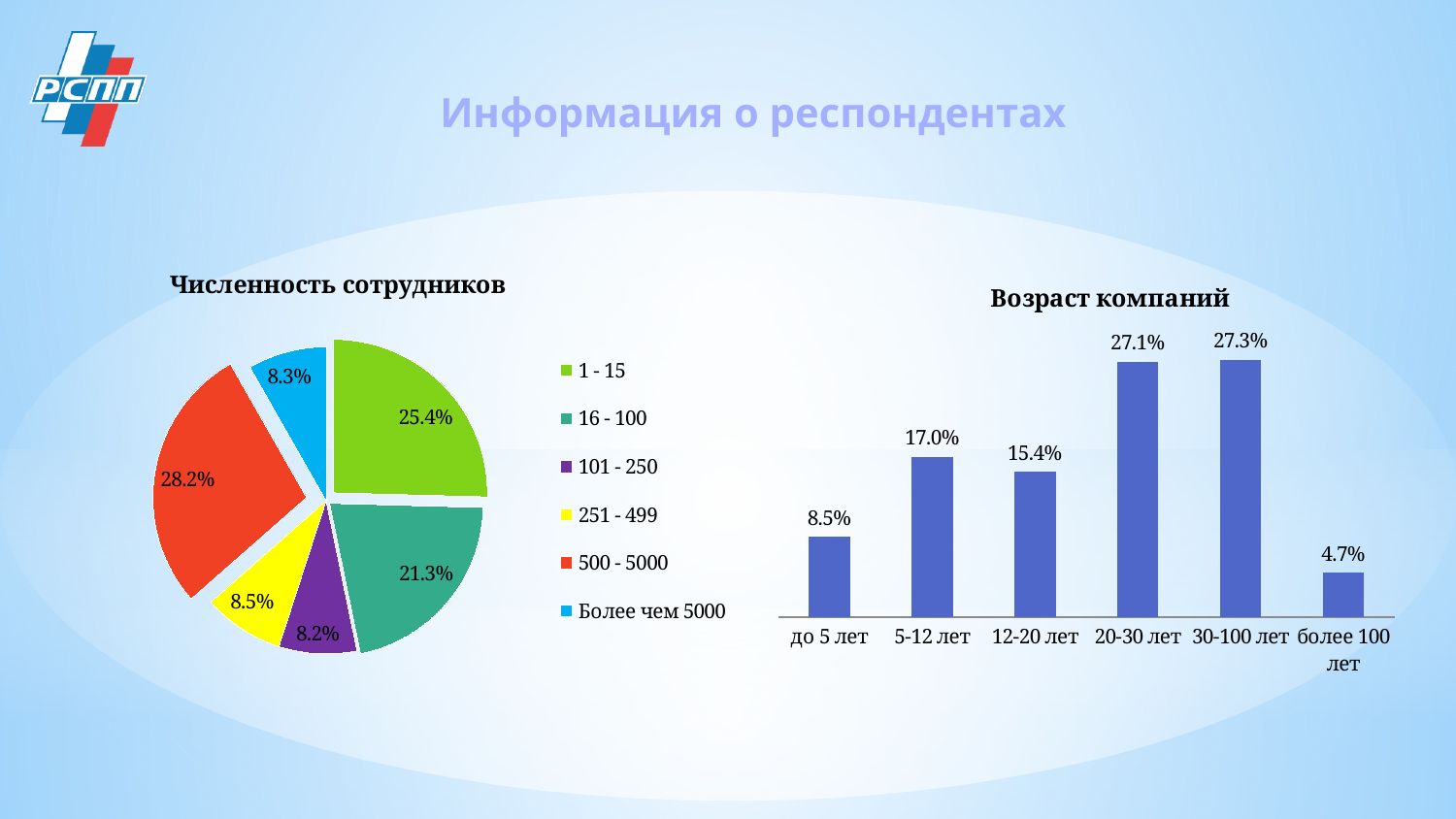
In the bar chart 'Возраст компаний', what is the value for '20-30 лет'? 27.1% In the bar chart 'Возраст компаний', which is larger: the value for '5-12 лет' or for '12-20 лет'? 5-12 лет In the bar chart 'Возраст компаний', which category has the lowest value? более 100 лет In the bar chart 'Возраст компаний', what is the value for 'более 100 лет'? 4.7% In the pie chart 'Численность сотрудников', what share is shown for the '500 - 5000' category? 28.2% In the pie chart 'Численность сотрудников', what is the difference between the '1 - 15' and '16 - 100' shares? 4.1% In the pie chart 'Численность сотрудников', which category has the largest slice? 500 - 5000 In the pie chart 'Численность сотрудников', which category has the smallest slice? 101 - 250 In the pie chart 'Численность сотрудников', how many categories does the legend list? 6 What type of chart is 'Возраст компаний'? Bar chart In the bar chart 'Возраст компаний', how many categories are shown on the x axis? 6 In the pie chart 'Численность сотрудников', what share is shown for the '1 - 15' category? 25.4%